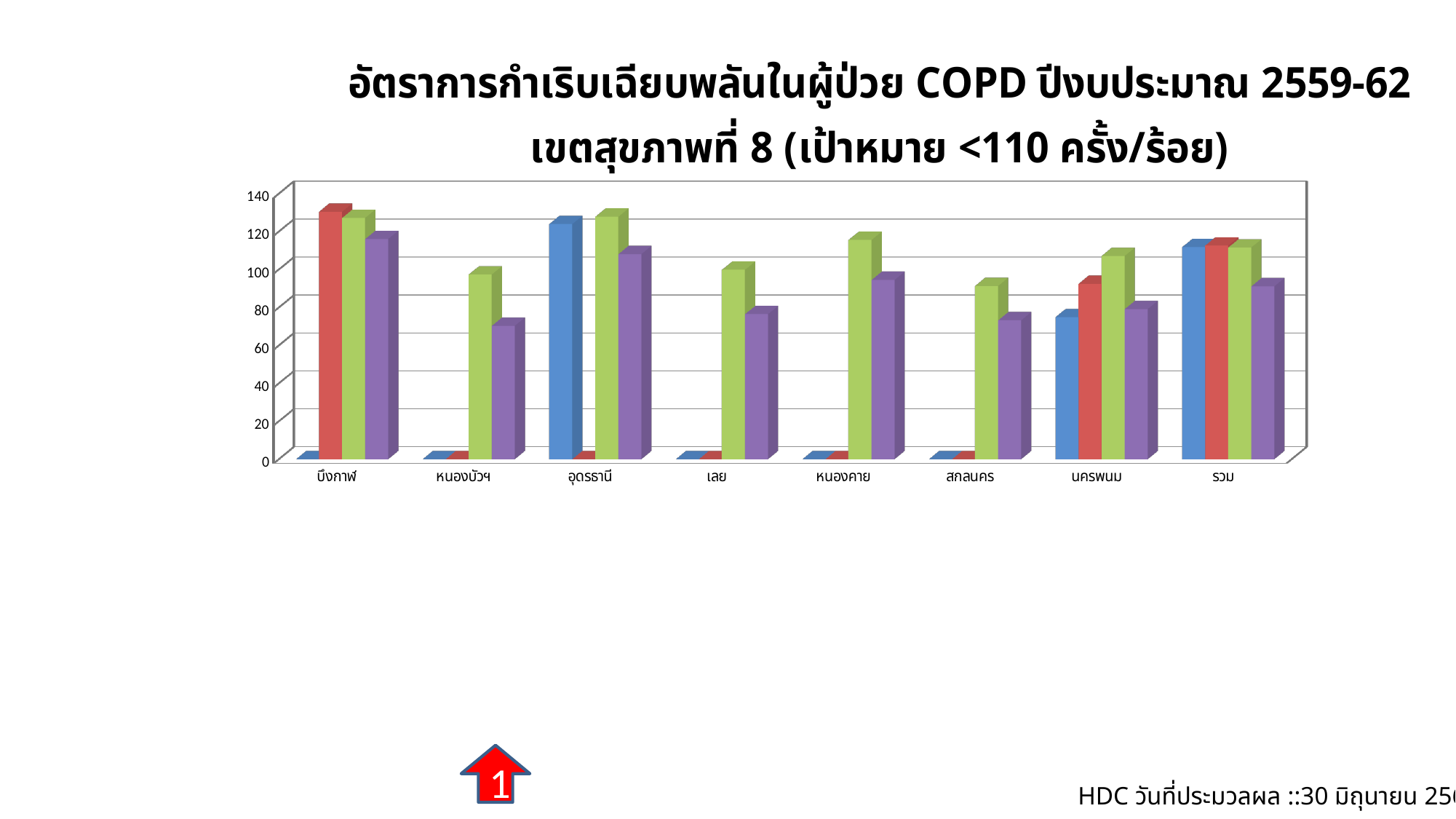
Is the value of the blue bar for รวม greater or less than 100? greater Which is larger: the red bar for บึงกาฬ or the green bar for หนองบัวฯ? the red bar for บึงกาฬ How many categories are shown along the x axis of the chart? 8 Among the purple bars, which category has the highest value? บึงกาฬ Is the value of the blue bar for นครพนม greater or less than 100? less Is the value of the red bar for บึงกาฬ greater or less than 120? greater Which is larger: the green bar for อุดรธานี or the green bar for เลย? the green bar for อุดรธานี What kind of chart is shown on the slide? bar chart What target value is stated in the chart title? <110 ครั้ง/ร้อย